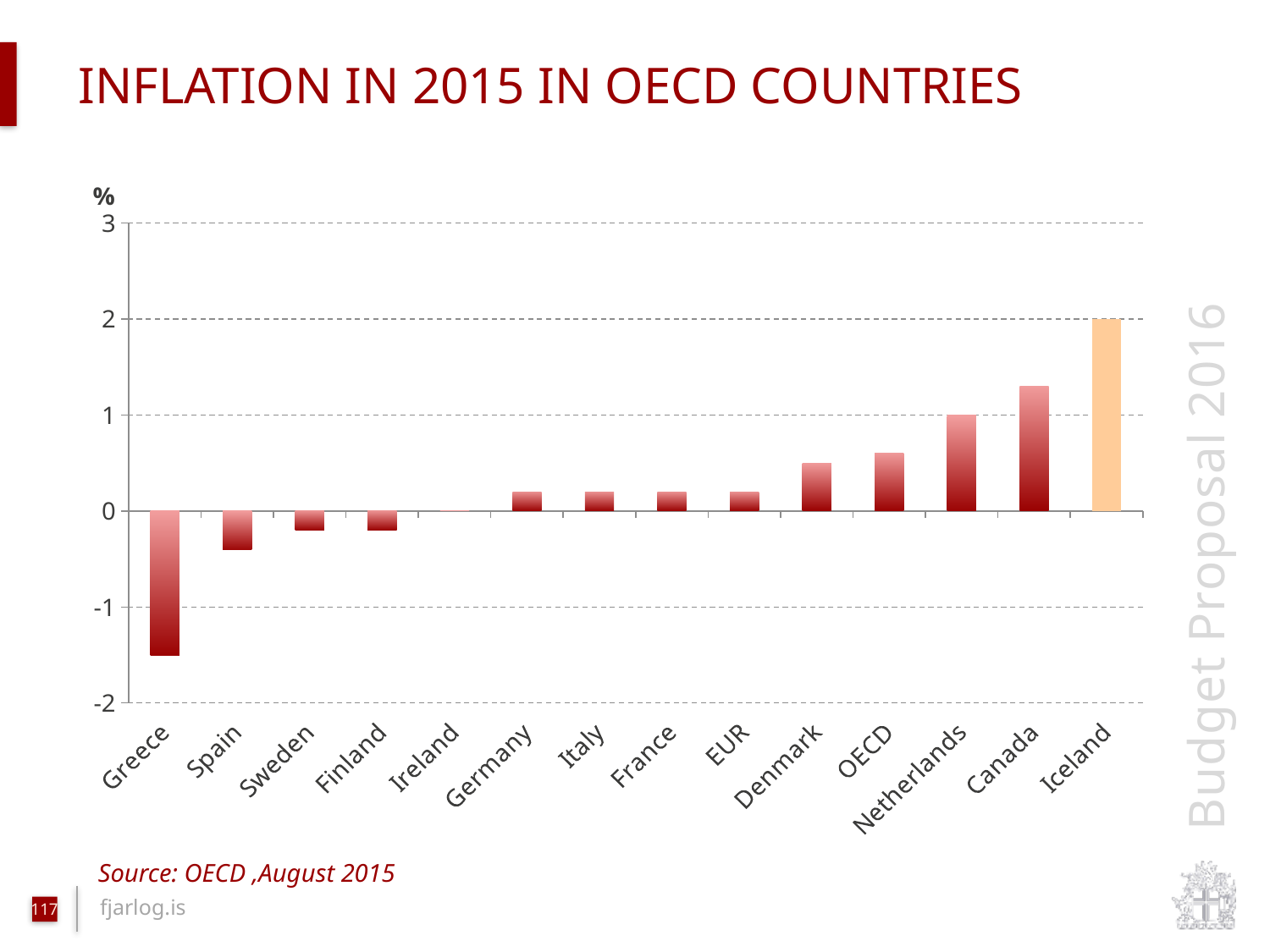
Is the value for Greece greater or less than -1? less What is the inflation value for Netherlands? 1 Which country's bar is shown in a different colour (orange) from the others? Iceland Is the value for Canada greater or less than 1? greater Which country has the highest inflation in the chart? Iceland Which country has the lowest inflation in the chart? Greece Do the values generally rise or fall from left to right along the x axis? rise Is the value for Denmark greater or less than 1? less What is the inflation value for Iceland? 2 Which has the larger inflation value, Canada or Netherlands? Canada What kind of chart is shown on the slide? bar chart How many countries or regions are shown on the x axis of the chart? 14